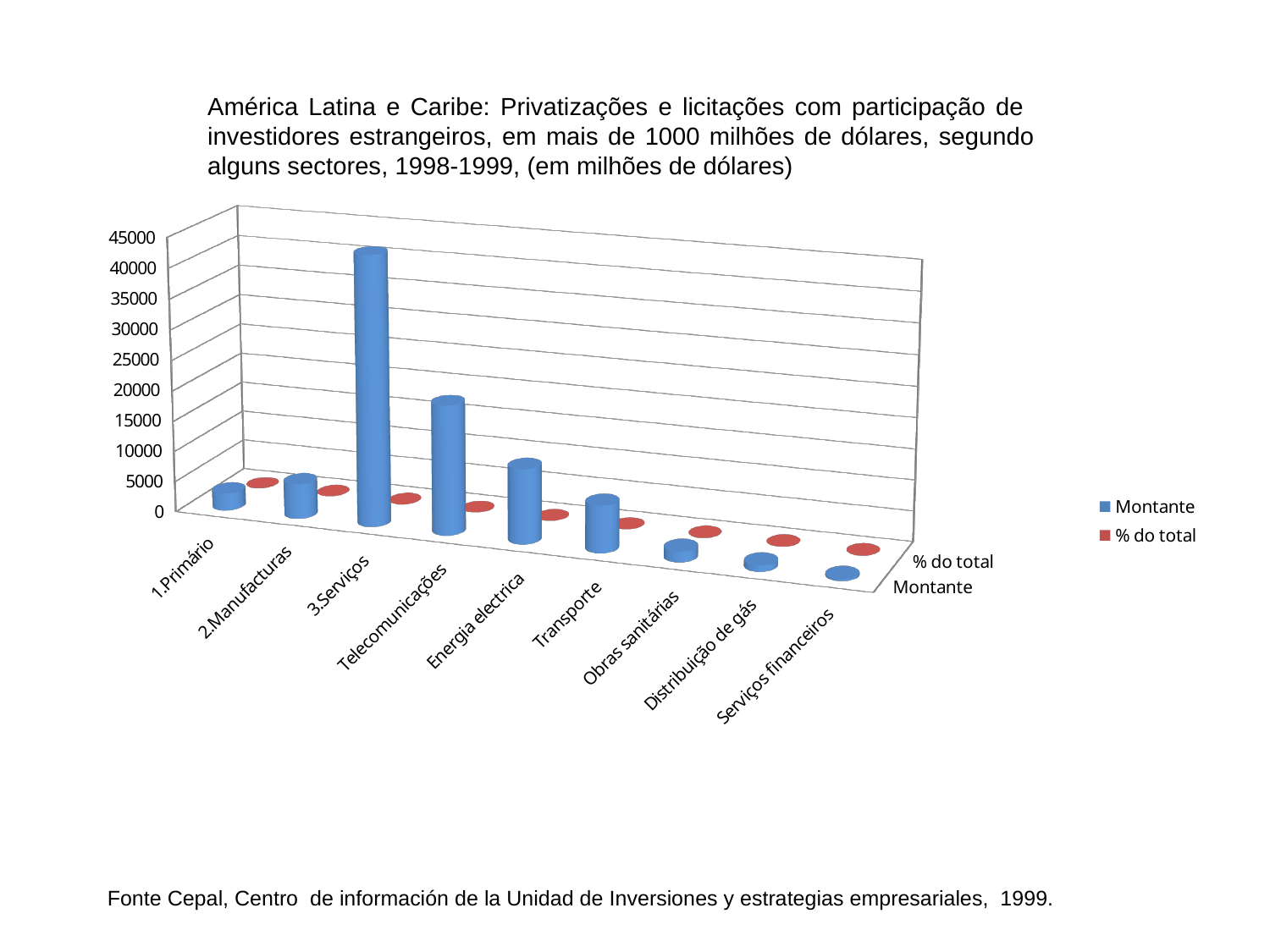
What colour represents the Montante series? blue How many series does the legend list? 2 Is the Montante value for 1.Primário greater or less than 10000? less What are the two series named in the legend? Montante and % do total Which has a larger Montante value, Telecomunicações or Energia electrica? Telecomunicações Is the Montante value for Telecomunicações greater or less than 10000? greater Is the Montante value for Energia electrica greater or less than 20000? less Which sector has the highest Montante value? 3.Serviços What kind of chart is shown on the slide? bar chart How many sector categories are shown on the x axis? 9 Which has a larger Montante value, 3.Serviços or Telecomunicações? 3.Serviços